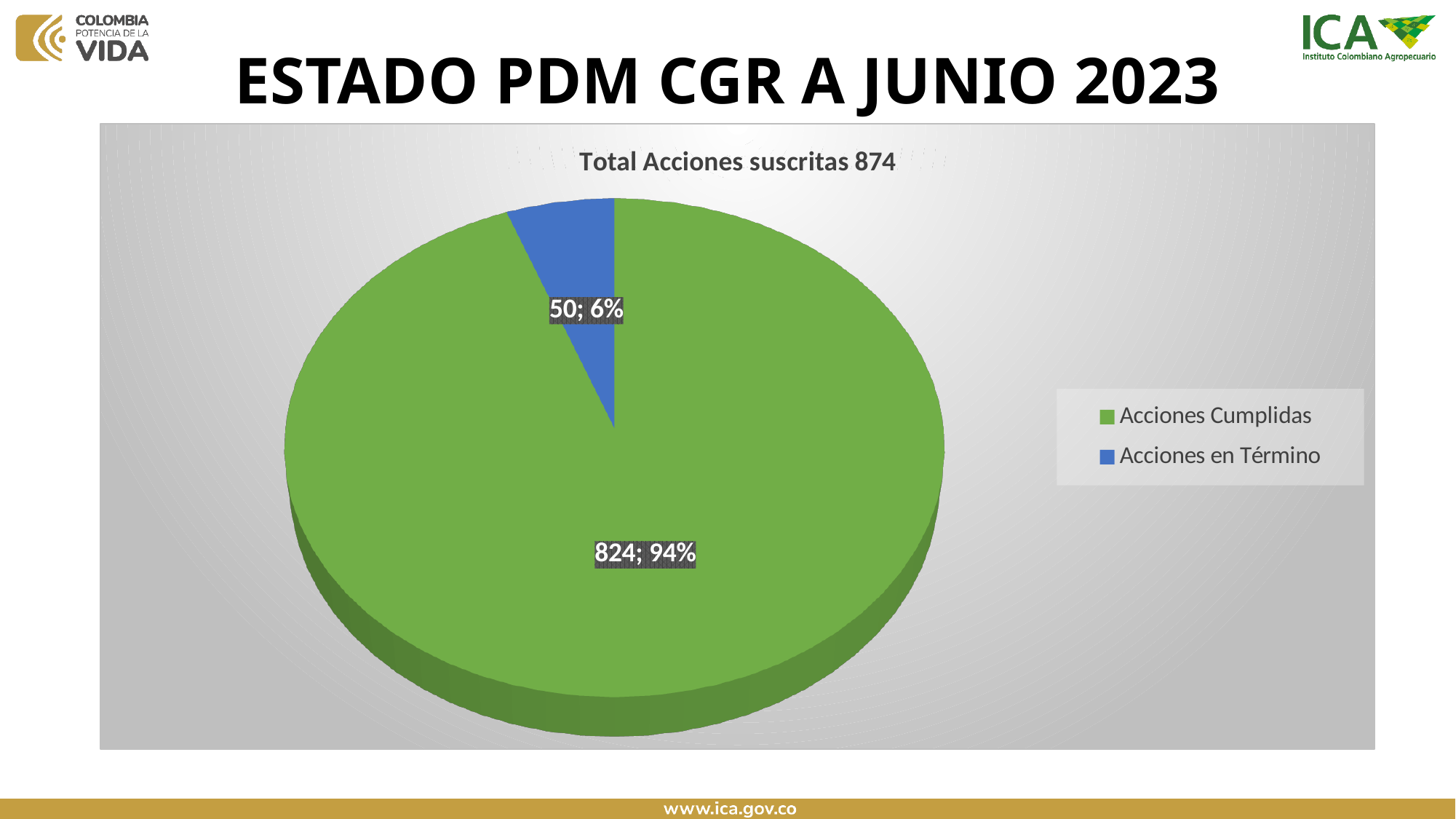
Which category has the smallest slice? Acciones en Término What share of the pie is Acciones Cumplidas? 94% Which category has the largest slice? Acciones Cumplidas What is the value for Acciones en Término? 50 What kind of chart is shown on the slide? pie chart What is the chart's title? Total Acciones suscritas 874 How many slices does the pie chart have? 2 What is the difference between the values for Acciones Cumplidas and Acciones en Término? 774 What is the value for Acciones Cumplidas? 824 How many entries does the legend list? 2 Which colour represents Acciones en Término in the chart? blue What share of the pie is Acciones en Término? 6%